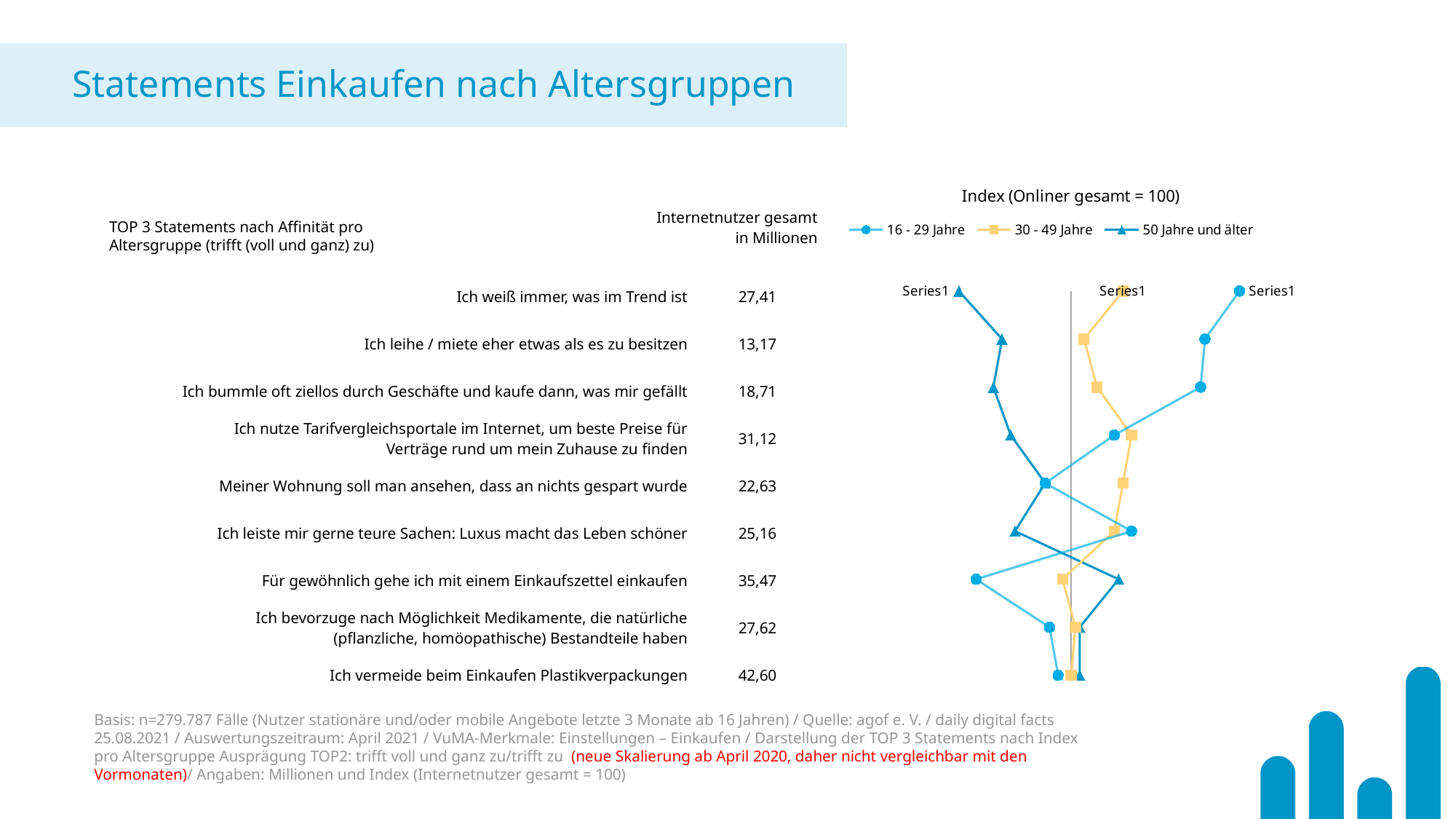
Which statement has the lowest Internetnutzer gesamt in Millionen? Ich leihe / miete eher etwas als es zu besitzen What kind of chart is shown on the slide? line chart For 'Ich weiß immer, was im Trend ist', which series has the higher index value: 16 - 29 Jahre or 50 Jahre und älter? 16 - 29 Jahre What is the value of Internetnutzer gesamt in Millionen for 'Ich vermeide beim Einkaufen Plastikverpackungen'? 42,60 How many statements are plotted in the chart? 9 Is the index value for 50 Jahre und älter for 'Ich weiß immer, was im Trend ist' greater or less than 100? less Which statement has the highest Internetnutzer gesamt in Millionen? Ich vermeide beim Einkaufen Plastikverpackungen Which age groups are listed in the chart legend? 16 - 29 Jahre, 30 - 49 Jahre, 50 Jahre und älter Is the index value for 16 - 29 Jahre for 'Für gewöhnlich gehe ich mit einem Einkaufszettel einkaufen' greater or less than 100? less Is the index value for 16 - 29 Jahre for 'Ich weiß immer, was im Trend ist' greater or less than 100? greater How many series does the chart legend list? 3